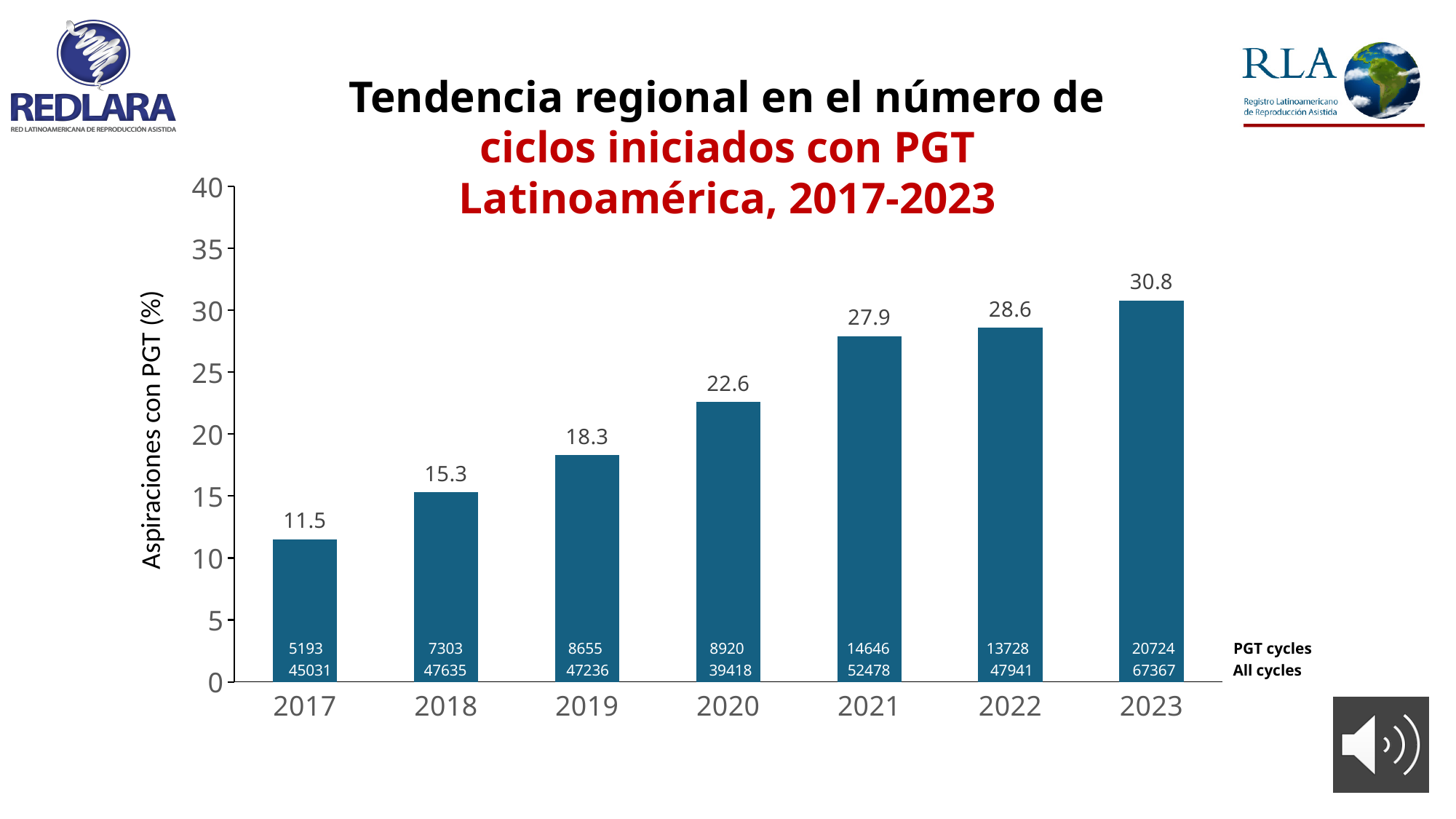
Which year has the highest percentage of aspirations with PGT? 2023 What kind of chart is shown on the slide? Bar chart Is the value for 2022 greater or less than 25? greater What is the difference in the PGT percentage between 2023 and 2017? 19.3 How many PGT cycles are shown for 2023? 20724 How many total cycles (All cycles) are shown for 2021? 52478 Which year has a higher PGT percentage, 2019 or 2021? 2021 What is the percentage of aspirations with PGT in 2020? 22.6 What is the percentage of aspirations with PGT in 2017? 11.5 Which year has the lowest percentage of aspirations with PGT? 2017 How many years are shown on the x axis? 7 Do the PGT percentages rise or fall from 2017 to 2023? Rise